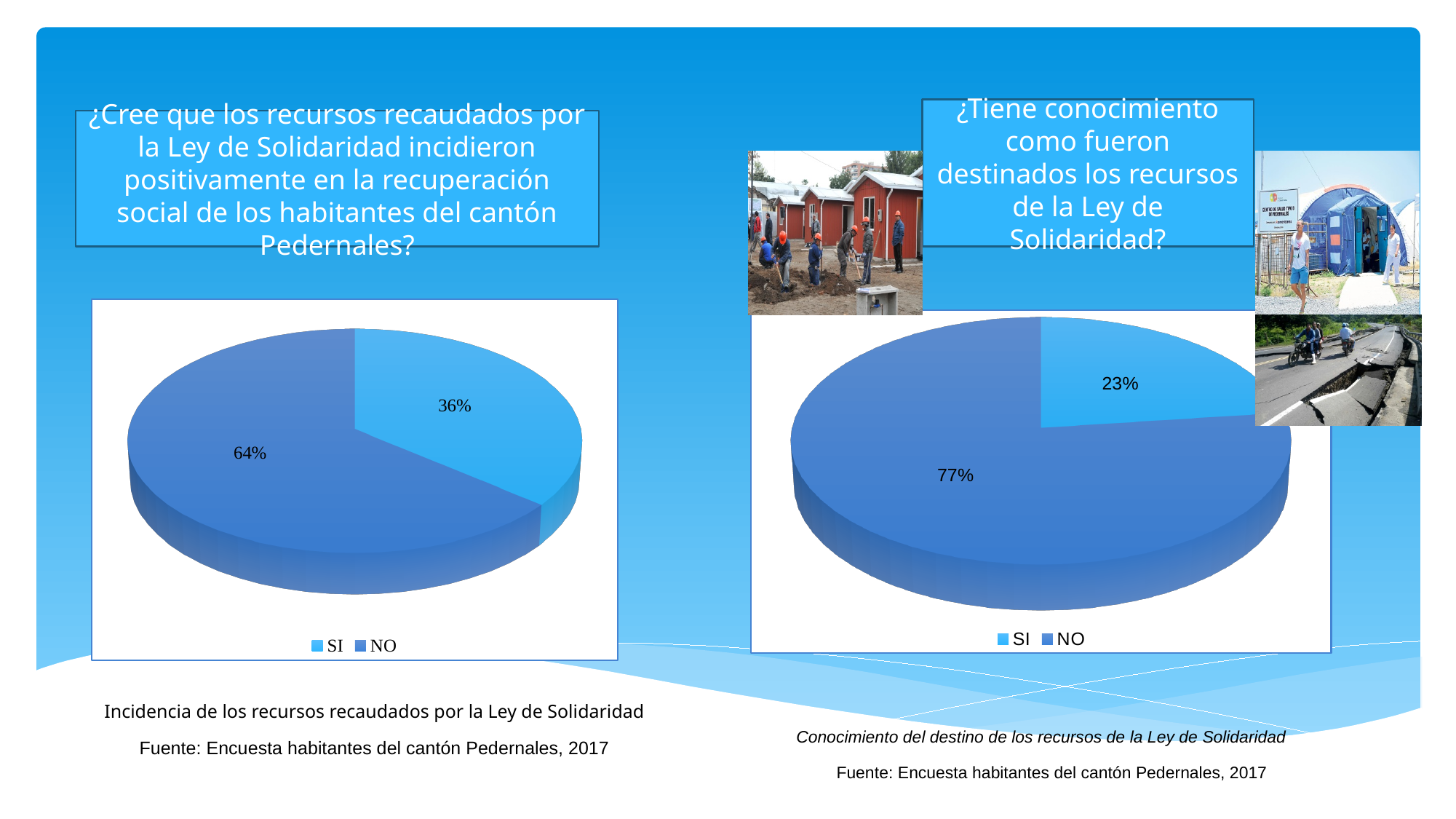
In the left pie chart, which category has the largest slice? NO In the right pie chart, what percentage is shown for SI? 23% In the right pie chart, what percentage is shown for NO? 77% Which chart has the larger SI share, the left chart or the right chart? the left chart What type of chart is used on the left side of the slide? pie chart In the left pie chart, what percentage is shown for SI? 36% In the right pie chart, what is the difference between the NO and SI percentages? 54% How many categories does the legend of the right pie chart list? 2 In the left pie chart, what percentage is shown for NO? 64% In the left pie chart, which legend entry is shown in the lighter blue colour? SI In the right pie chart, which category has the smallest slice? SI In the left pie chart, what is the difference between the NO and SI percentages? 28%